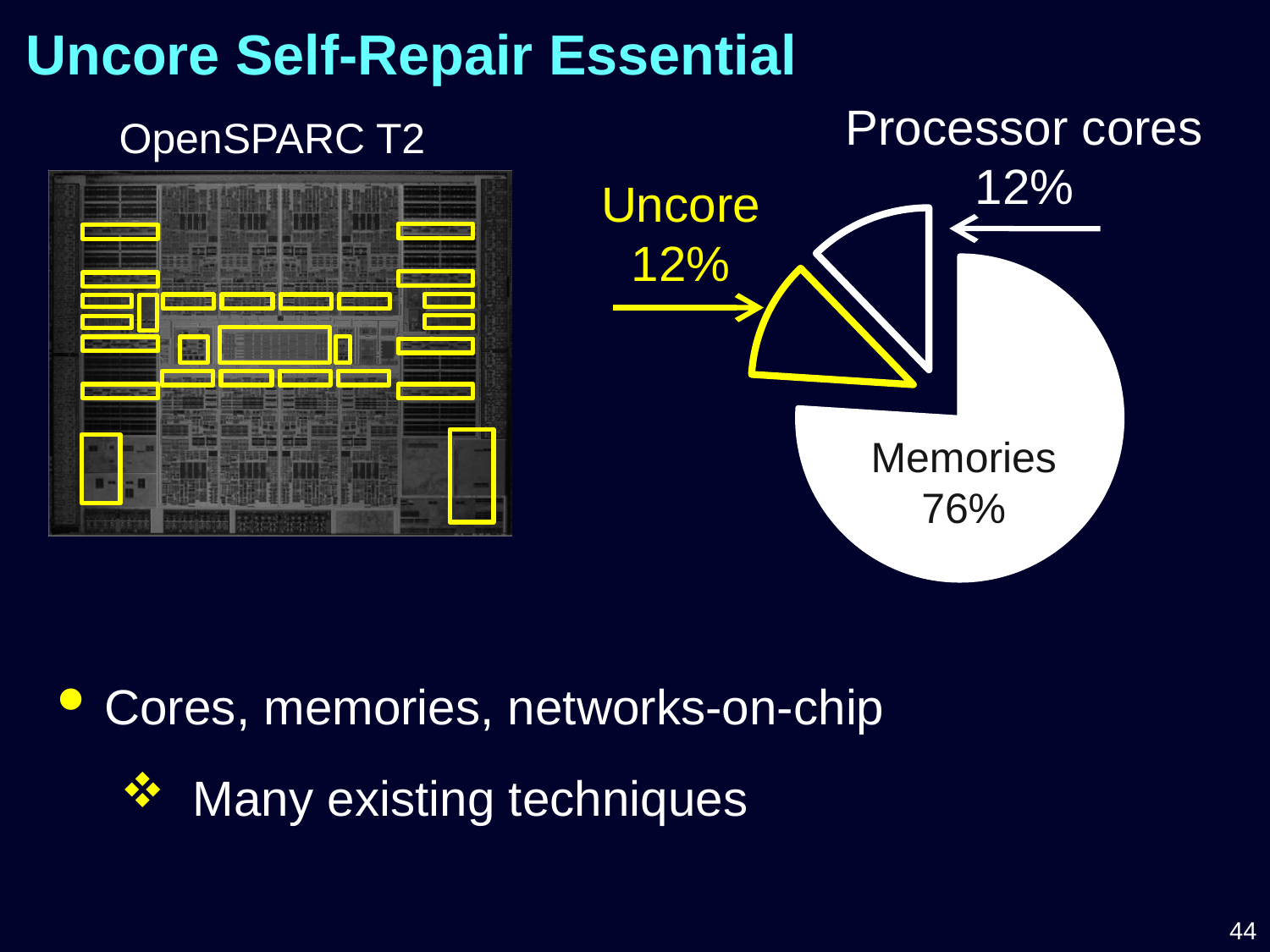
What is the difference between the Memories share and the Uncore share in the pie chart? 64% What share of the pie chart is Processor cores? 12% How many slices does the pie chart have? 3 Which slice of the pie chart is the largest? Memories Which slice of the pie chart is outlined in yellow? Uncore What kind of chart is shown on the slide? pie chart Which is larger in the pie chart, Memories or Uncore? Memories What share of the pie chart is Memories? 76% Which is larger in the pie chart, Processor cores or Memories? Memories What share of the pie chart is Uncore? 12% Which chip is named above the die photo on the left of the slide? OpenSPARC T2 What is the difference between the Memories share and the Processor cores share in the pie chart? 64%